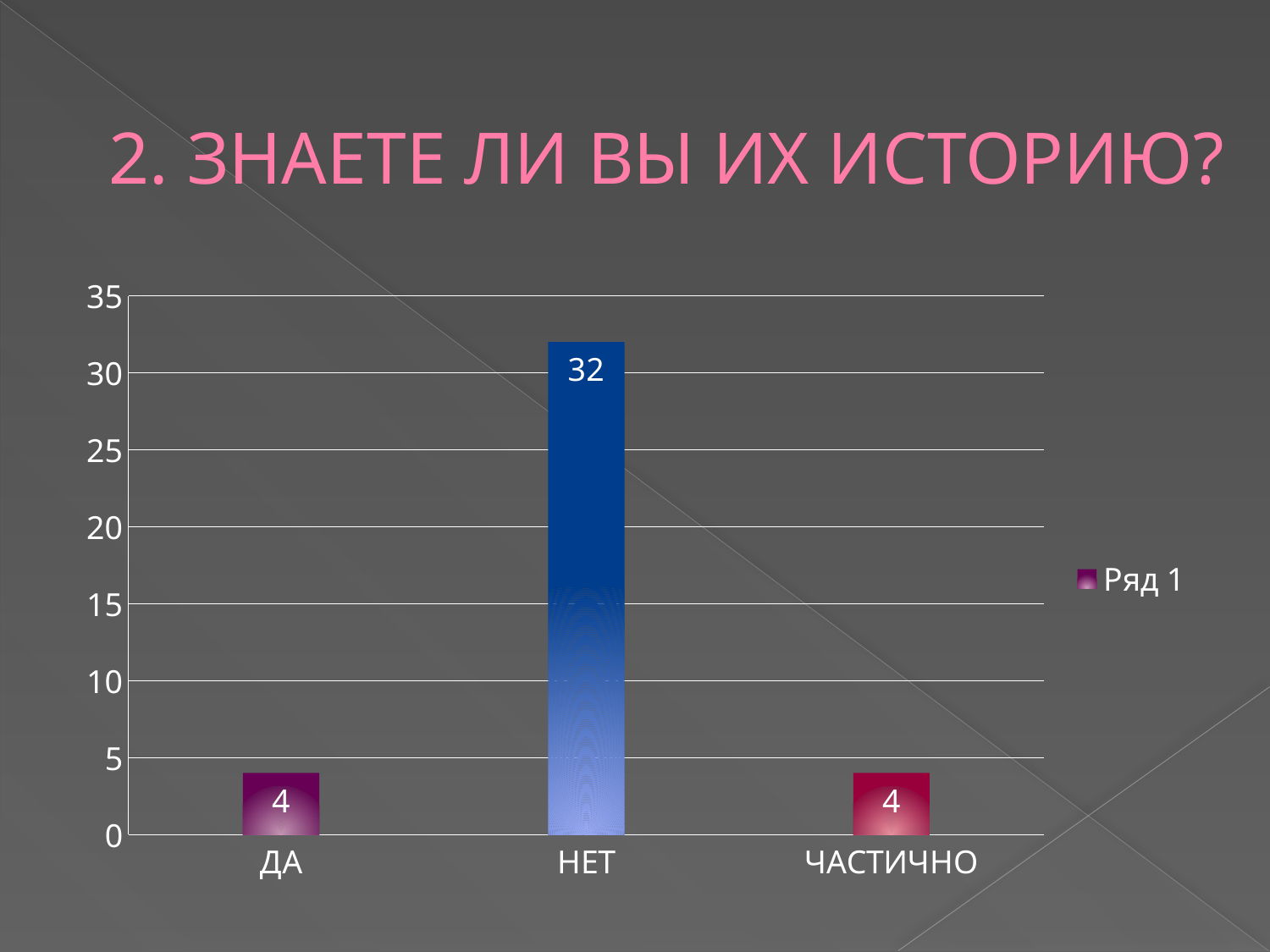
Which category has the highest value? НЕТ What is the value for ЧАСТИЧНО? 4 What is the value for НЕТ? 32 What is the difference between the values for НЕТ and ДА? 28 Is the value for НЕТ greater or less than 30? greater What is the value for ДА? 4 Which is larger, the value for НЕТ or the value for ЧАСТИЧНО? НЕТ What kind of chart is shown on the slide? bar chart Is the value for ДА greater or less than 5? less How many series does the legend list? 1 What is the name of the series in the legend? Ряд 1 How many categories are shown on the x axis? 3